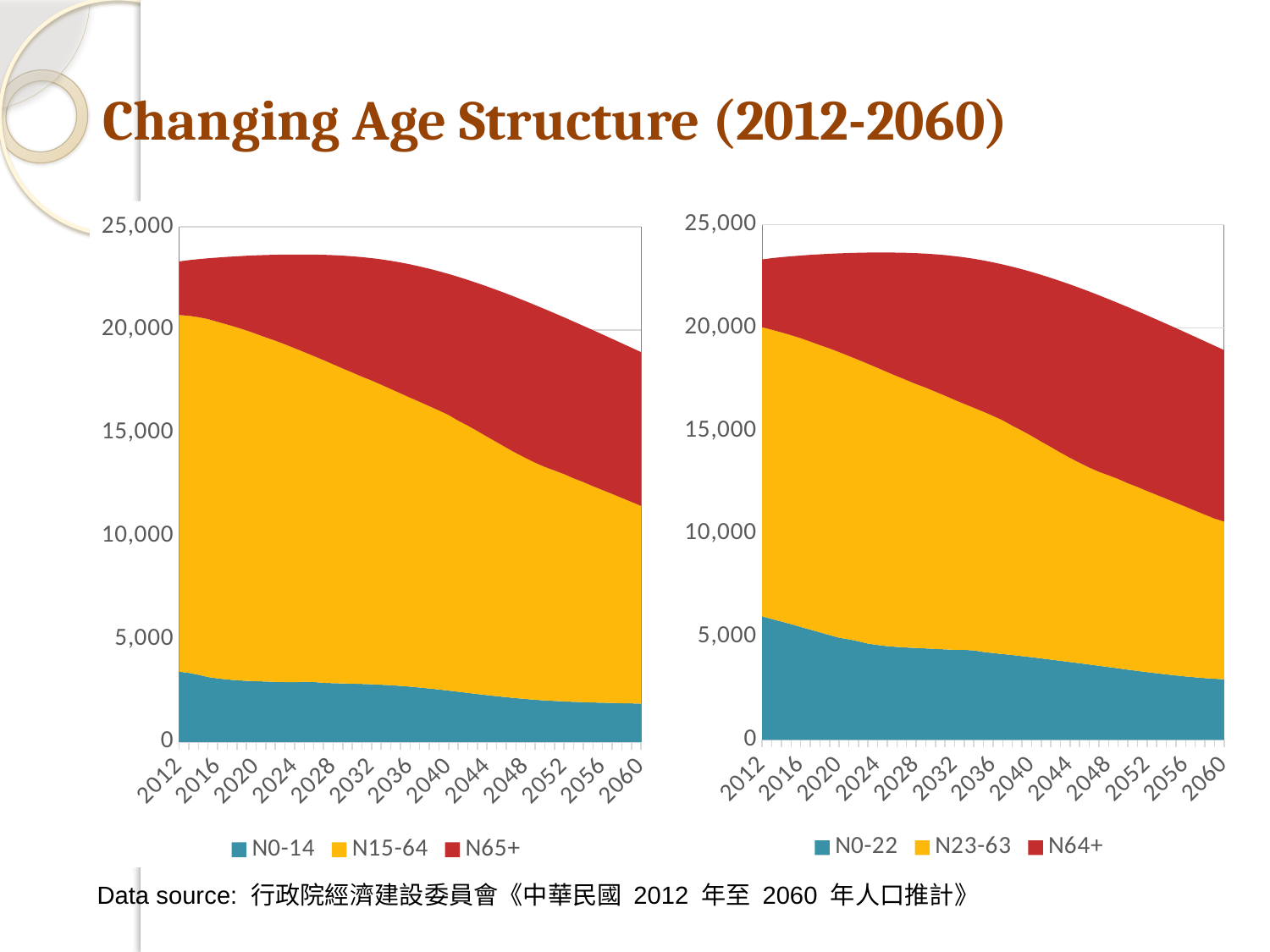
In the left chart, is the total of all three series in 2012 greater or less than 20,000? greater In the left chart, which series is shown in red? N65+ How many series does the legend of the right chart list? 3 In the right chart, is the total of all three series in 2060 greater or less than 20,000? less What are the three legend entries of the right chart? N0-22, N23-63, N64+ How many year labels are shown on the x axis of the left chart? 13 In the right chart, is the value for N0-22 in 2060 greater or less than 5,000? less How many series does the legend of the left chart list? 3 In the left chart, does the N0-14 series rise or fall from 2012 to 2060? fall What kind of chart is the left chart on the slide? stacked area chart